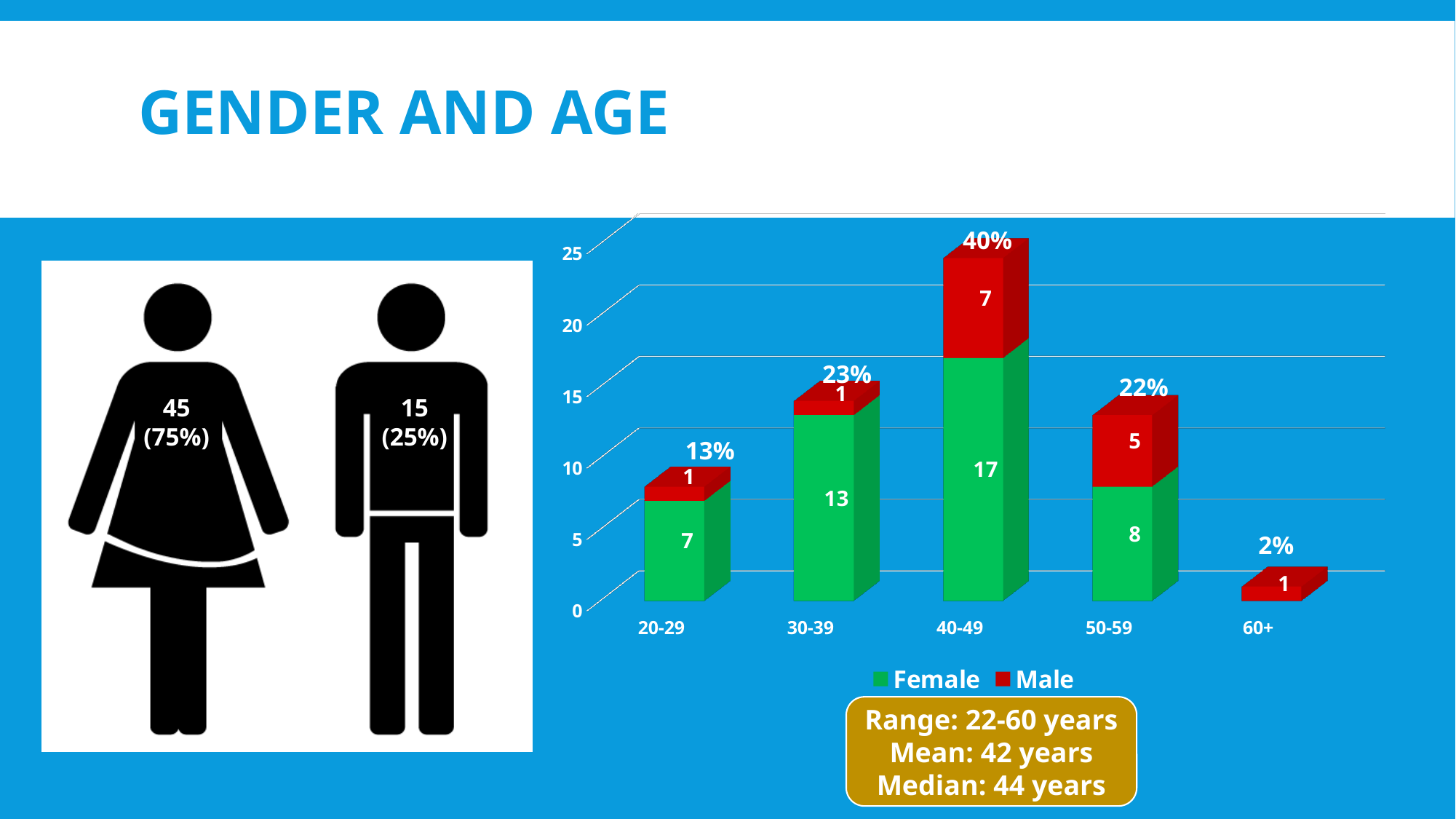
What is the Male value for the 50-59 age group? 5 What percentage label is shown above the 40-49 age group bar? 40% Which age group has the highest Female value? 40-49 What is the Female value for the 30-39 age group? 13 How many age groups are shown on the x axis? 5 How many series does the legend list? 2 What kind of chart is shown on the slide? Stacked bar chart What is the total of the stacked bar for the 50-59 age group? 13 Which is larger, the Male value for 40-49 or the Male value for 50-59? 40-49 What is the difference between the Female values for 40-49 and 30-39? 4 What is the Female value for the 40-49 age group? 17 Which age group has the lowest percentage label? 60+